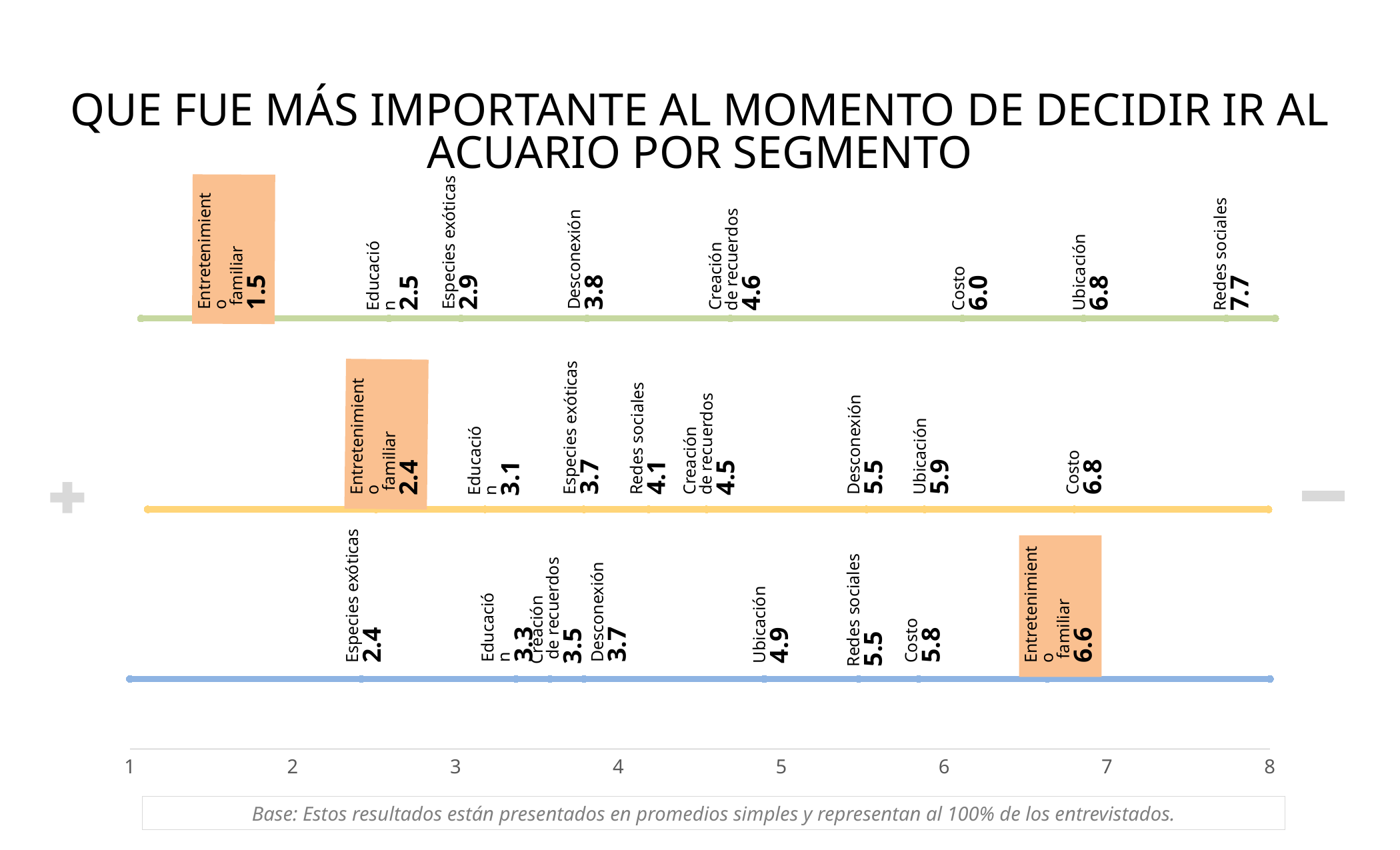
What is the value for Ubicación on the top (green) line? 6.8 On the top (green) line, what is the value for Redes sociales? 7.7 On the bottom (blue) line, what is the value for Entretenimiento familiar? 6.6 On the middle (yellow) line, what is the value for Costo? 6.8 On the top (green) line, what is the difference between the values for Redes sociales and Entretenimiento familiar? 6.2 How many categories are plotted on the top (green) line? 8 On the bottom (blue) line, what is the difference between the values for Costo and Especies exóticas? 3.4 On the bottom (blue) line, which category has the highest value? Entretenimiento familiar On the middle (yellow) line, which is larger: the value for Desconexión or the value for Redes sociales? Desconexión On the middle (yellow) line, which category has the lowest value? Entretenimiento familiar On the top (green) line, which category has the lowest value? Entretenimiento familiar How many horizontal lines (segments) are plotted on the chart? 3